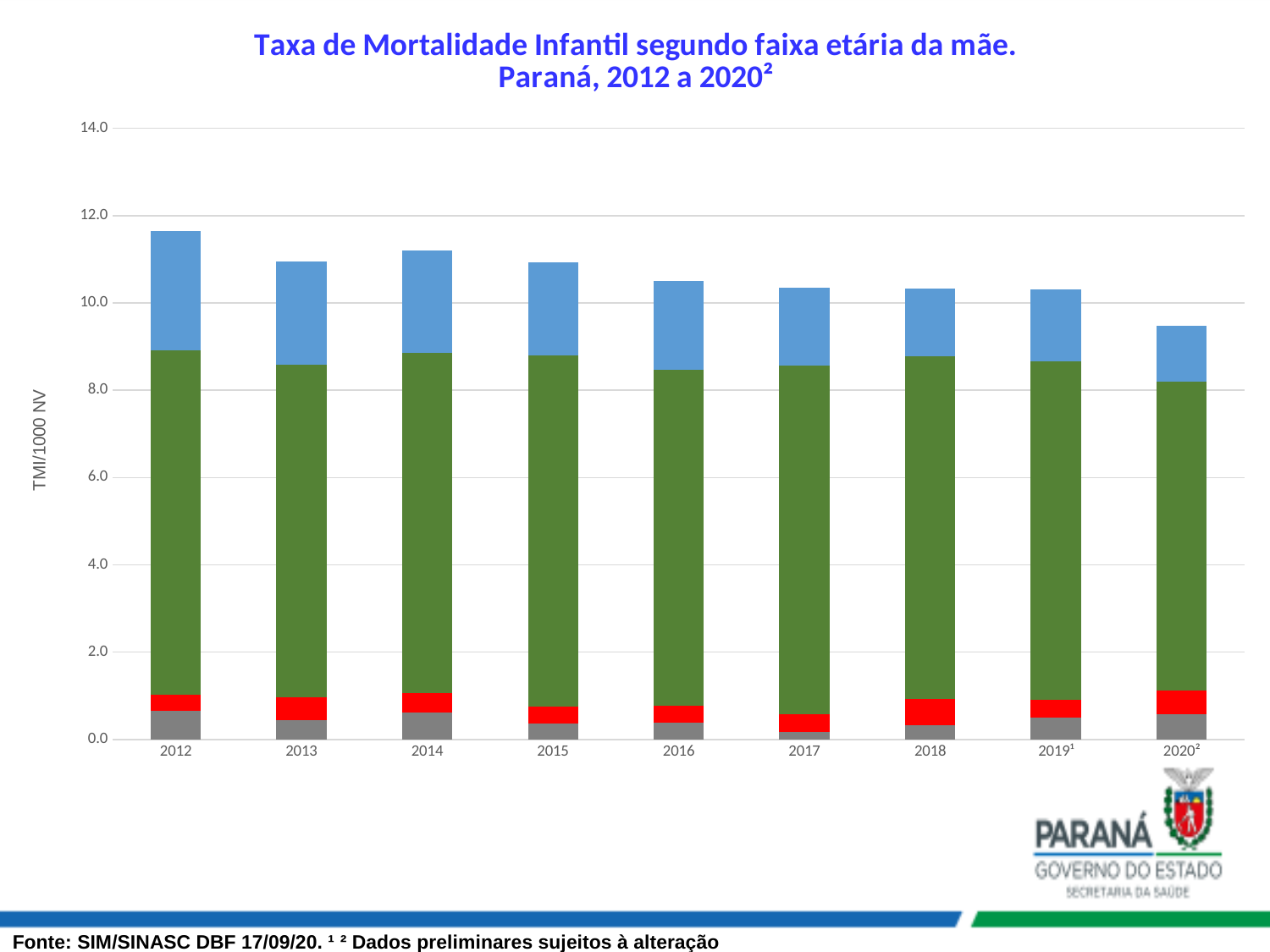
Do the total bar heights generally rise or fall from 2012 to 2020²? fall Is the total height of the 2012 bar greater or less than 10.0? greater Is the total height of the 2020² bar greater or less than 10.0? less Which year has the tallest stacked bar overall? 2012 Which year has the shortest stacked bar overall? 2020² How many years (bars) are plotted on the x axis? 9 Which bar is taller overall, 2012 or 2020²? 2012 What is the label on the y axis? TMI/1000 NV What kind of chart is shown on the slide? Stacked bar chart What is the title of the chart? Taxa de Mortalidade Infantil segundo faixa etária da mãe. Paraná, 2012 a 2020² Is the total height of the 2016 bar greater or less than 12.0? less